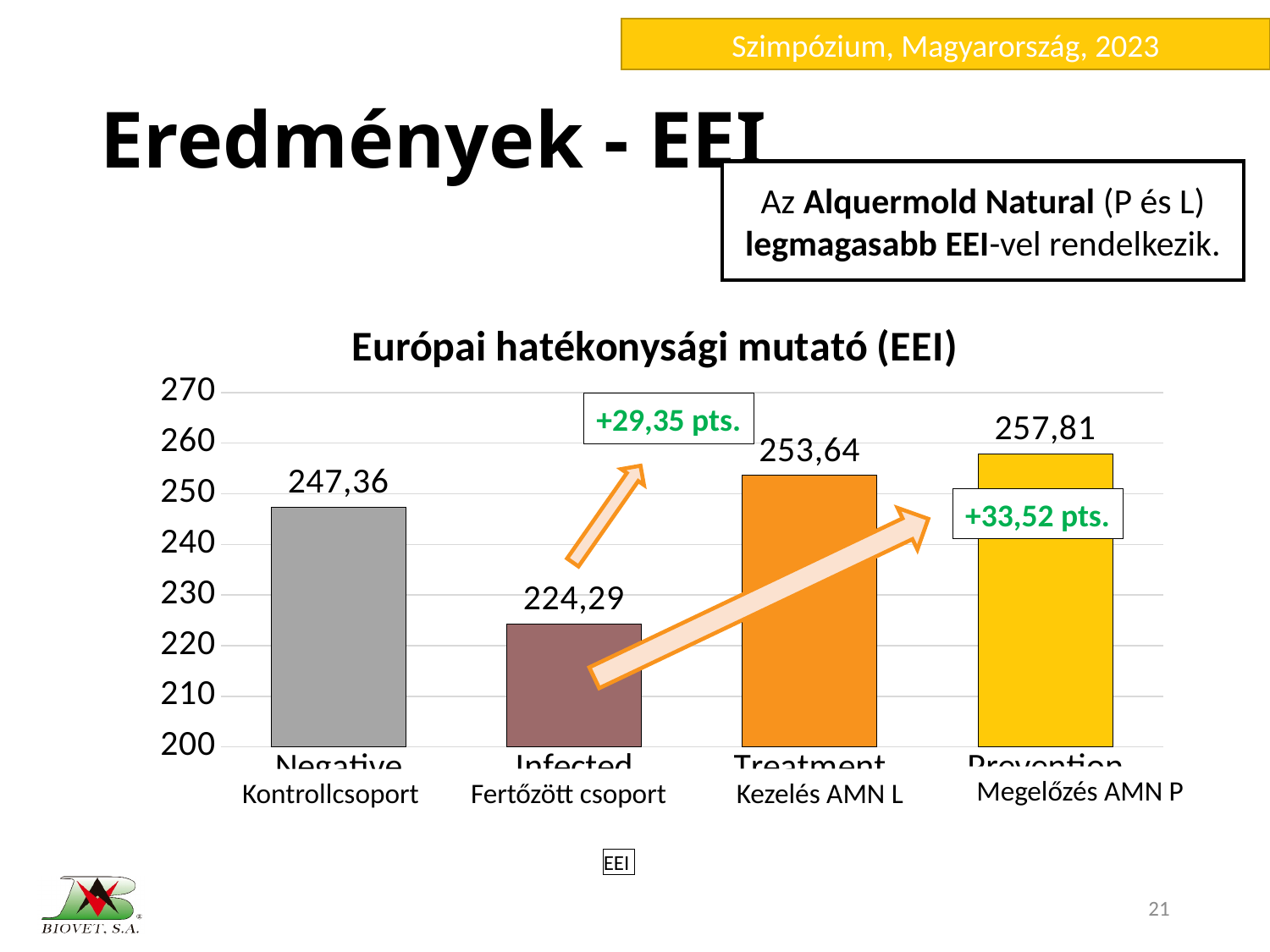
Which group has the lowest EEI value? Fertőzött csoport Which has a higher EEI value, Kontrollcsoport or Kezelés AMN L? Kezelés AMN L Which group has the highest EEI value? Megelőzés AMN P What is the EEI value for Kontrollcsoport? 247,36 What is the difference in EEI between Megelőzés AMN P and Fertőzött csoport? 33,52 What is the title of the chart? Európai hatékonysági mutató (EEI) What type of chart is used to show the EEI values? Bar chart What is the difference in EEI between Kezelés AMN L and Fertőzött csoport? 29,35 What is the EEI value for Kezelés AMN L? 253,64 What is the EEI value for Fertőzött csoport? 224,29 What is the EEI value for Megelőzés AMN P? 257,81 How many groups are shown in the chart? 4